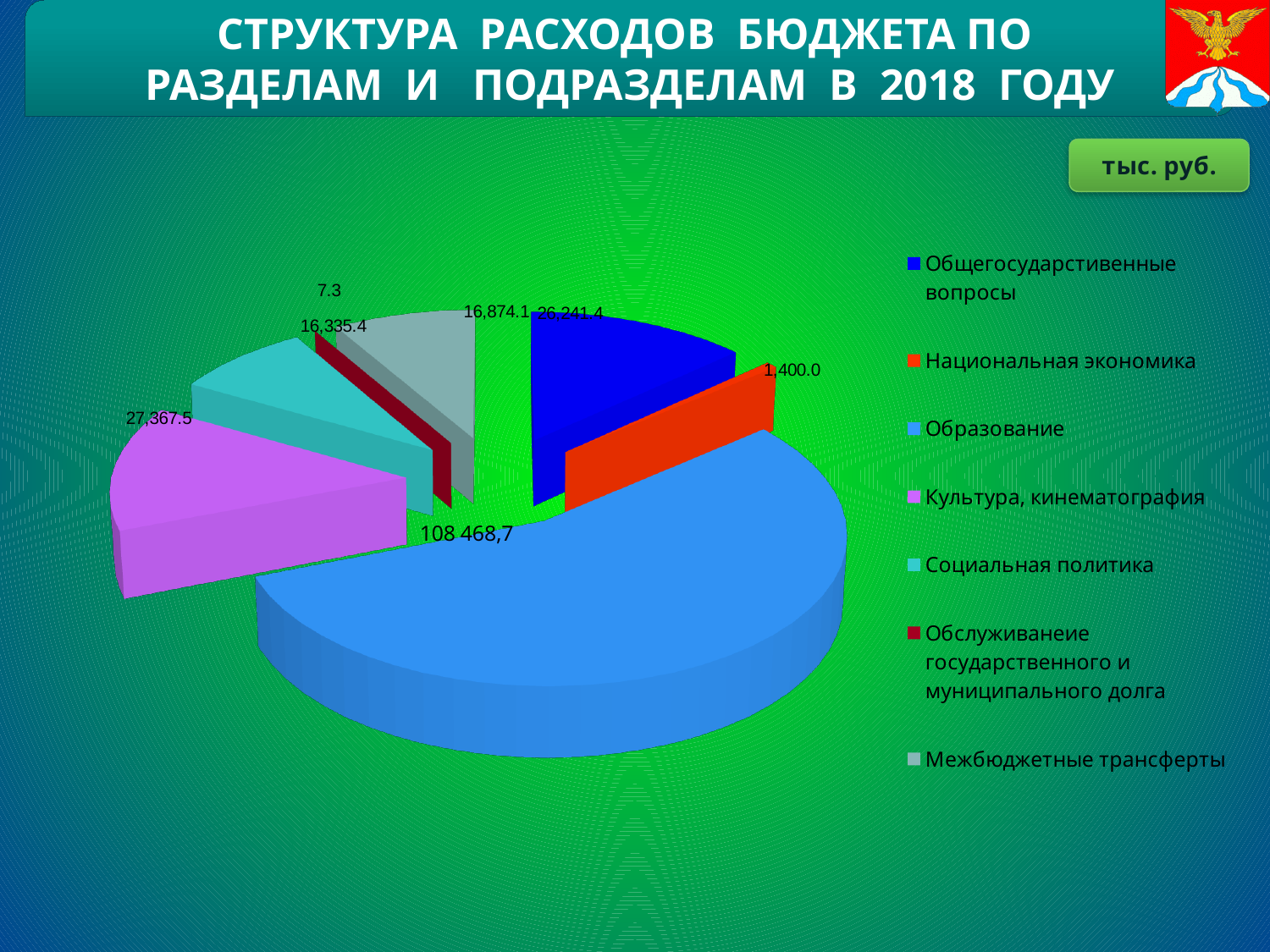
Which category has the largest slice of the pie? Образование What is the value shown for Межбюджетные трансферты? 16,874.1 What is the value shown for Национальная экономика? 1,400.0 What is the value shown for Образование? 108 468,7 Which category has the smallest value in the pie chart? Обслуживание государственного и муниципального долга What is the value shown for Социальная политика? 16,335.4 What type of chart is shown on the slide? pie chart What is the value shown for Обслуживание государственного и муниципального долга? 7.3 What is the value shown for Культура, кинематография? 27,367.5 Which is larger, the value for Культура, кинематография or the value for Социальная политика? Культура, кинематография What is the difference between the values for Межбюджетные трансферты and Социальная политика? 538.7 How many categories does the legend of the pie chart list? 7